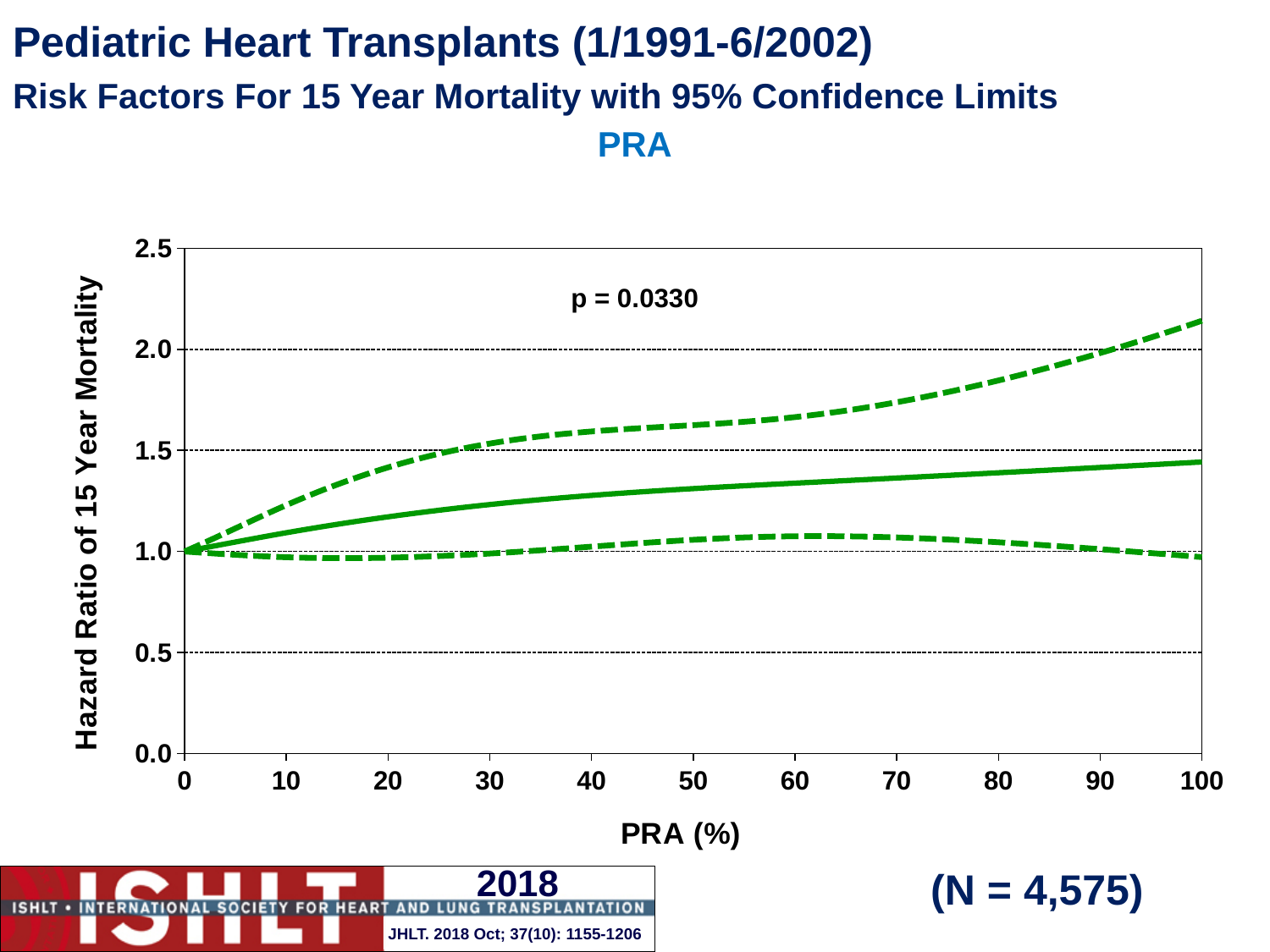
What p-value is shown on the chart? p = 0.0330 Is the value of the upper dashed confidence limit at PRA 100% greater or less than 2.0? greater What is the sample size (N) shown on the slide? N = 4,575 Is the solid line higher at PRA 100% or at PRA 10%? PRA 100% Is the value of the solid line at PRA 100% greater or less than 1.0? greater Is the value of the solid line at PRA 50% greater or less than 1.5? less How many lines are plotted on the chart? 3 What kind of chart is shown on the slide? line chart What is the hazard ratio of the solid line at PRA 0%? 1.0 Does the solid hazard ratio line rise or fall as PRA increases from 0 to 100%? rise Which of the three lines is highest at PRA 100%? the upper dashed confidence limit